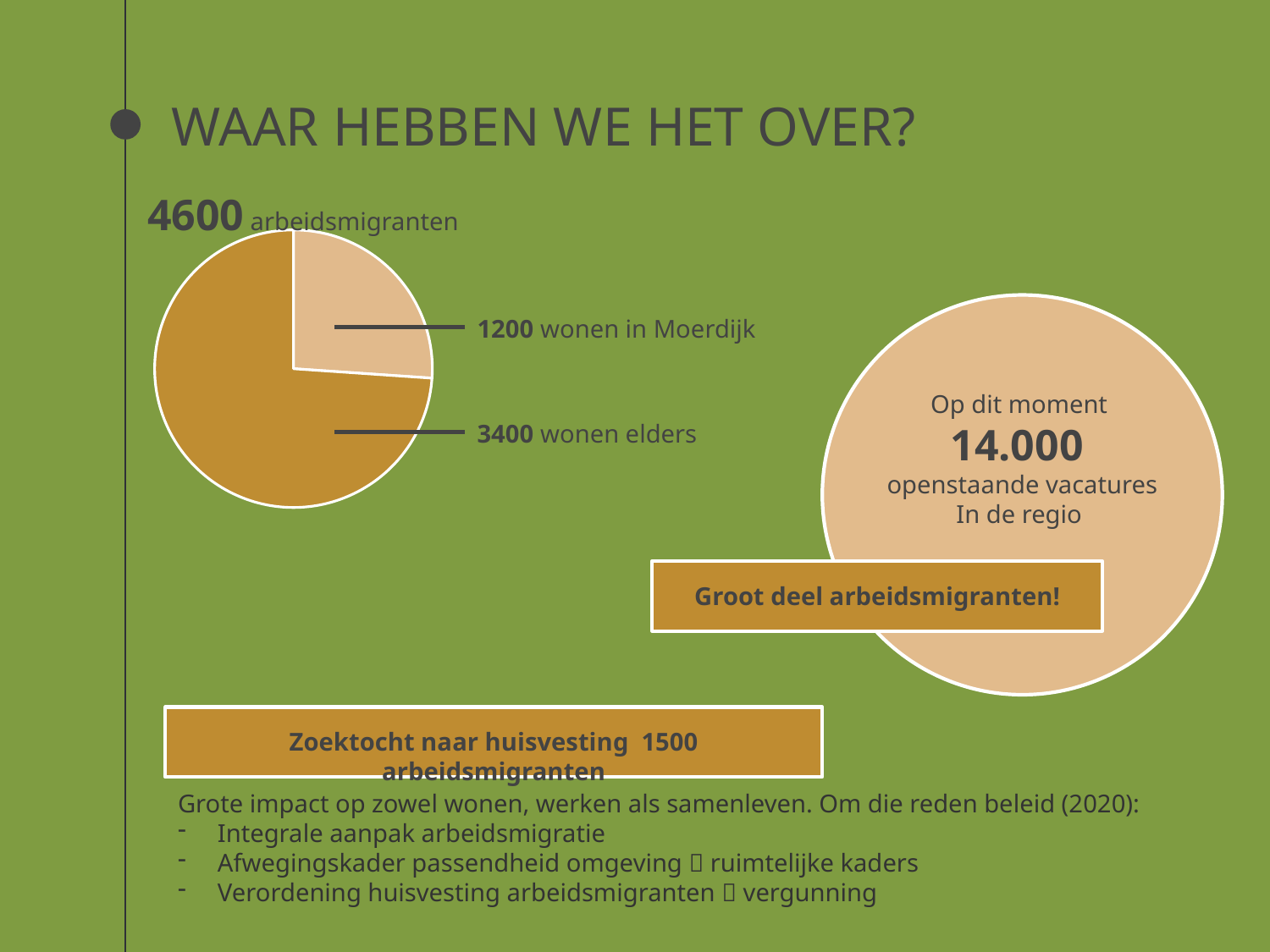
What label appears above the pie chart? 4600 arbeidsmigranten What is the total number of arbeidsmigranten represented by the pie chart? 4600 How many arbeidsmigranten 'wonen in Moerdijk' according to the pie chart? 1200 What is the difference between the number who 'wonen elders' and the number who 'wonen in Moerdijk'? 2200 Which is larger: the number who 'wonen in Moerdijk' or the number who 'wonen elders'? wonen elders How many arbeidsmigranten 'wonen elders' according to the pie chart? 3400 Which slice of the pie chart is the smallest? wonen in Moerdijk Which slice of the pie chart is the largest? wonen elders How many slices does the pie chart have? 2 Which slice of the pie chart is shown in the lighter colour? wonen in Moerdijk What type of chart is shown on the slide? pie chart